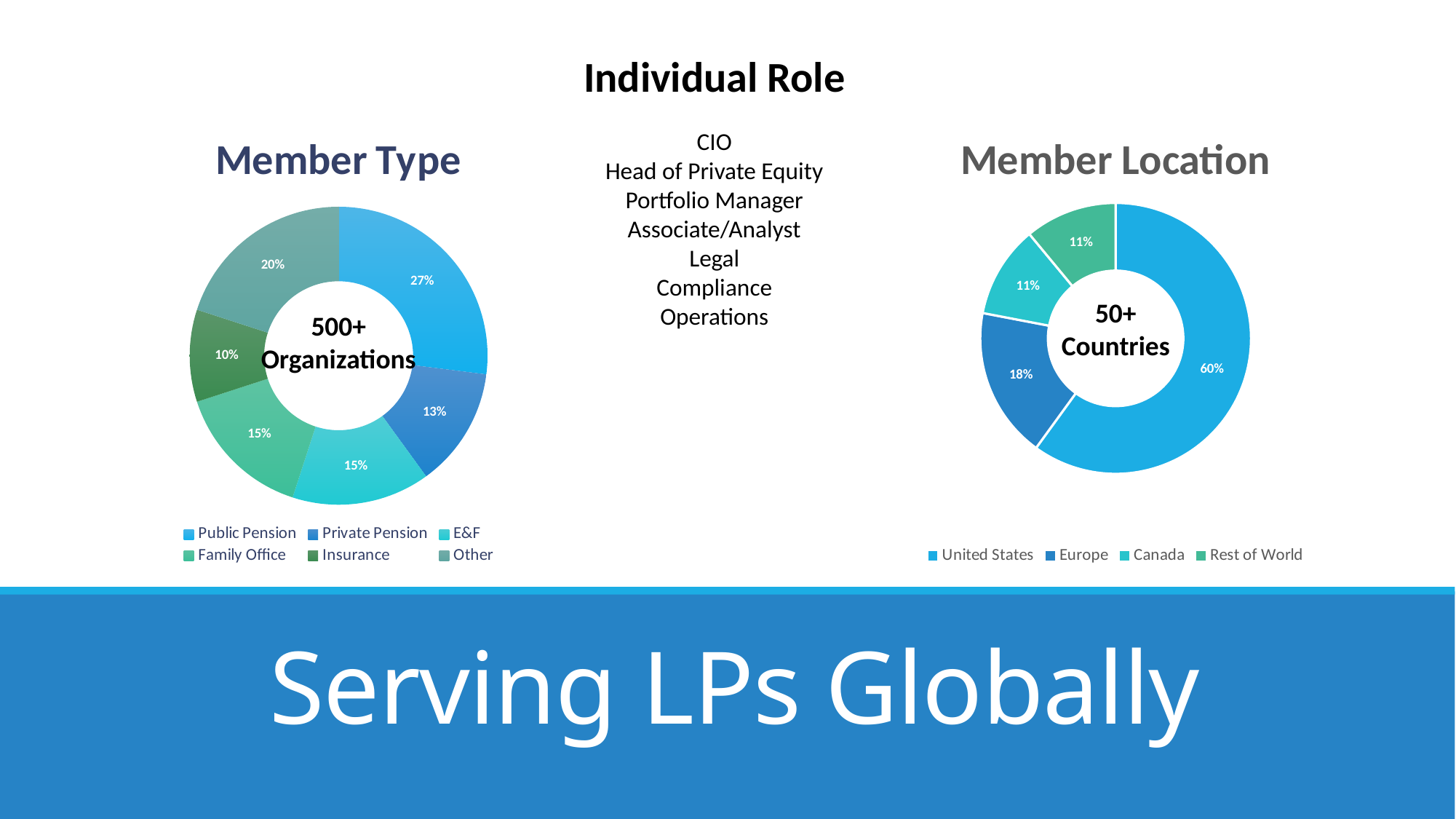
In the Member Type chart, which category has the largest share? Public Pension In the Member Location chart, how many categories does the legend list? 4 In the Member Location chart, what share is Europe? 18% In the Member Type chart, which category has the smallest share? Insurance In the Member Location chart, which category has the largest share? United States What kind of chart is the Member Location chart? Donut (pie) chart In the Member Type chart, what share is Insurance? 10% In the Member Type chart, what share is Public Pension? 27% In the Member Location chart, what is the difference between the United States share and the Europe share? 42% In the Member Type chart, how many categories are shown? 6 What text appears in the centre of the Member Type chart? 500+ Organizations In the Member Type chart, what is the difference between the Other share and the Private Pension share? 7%